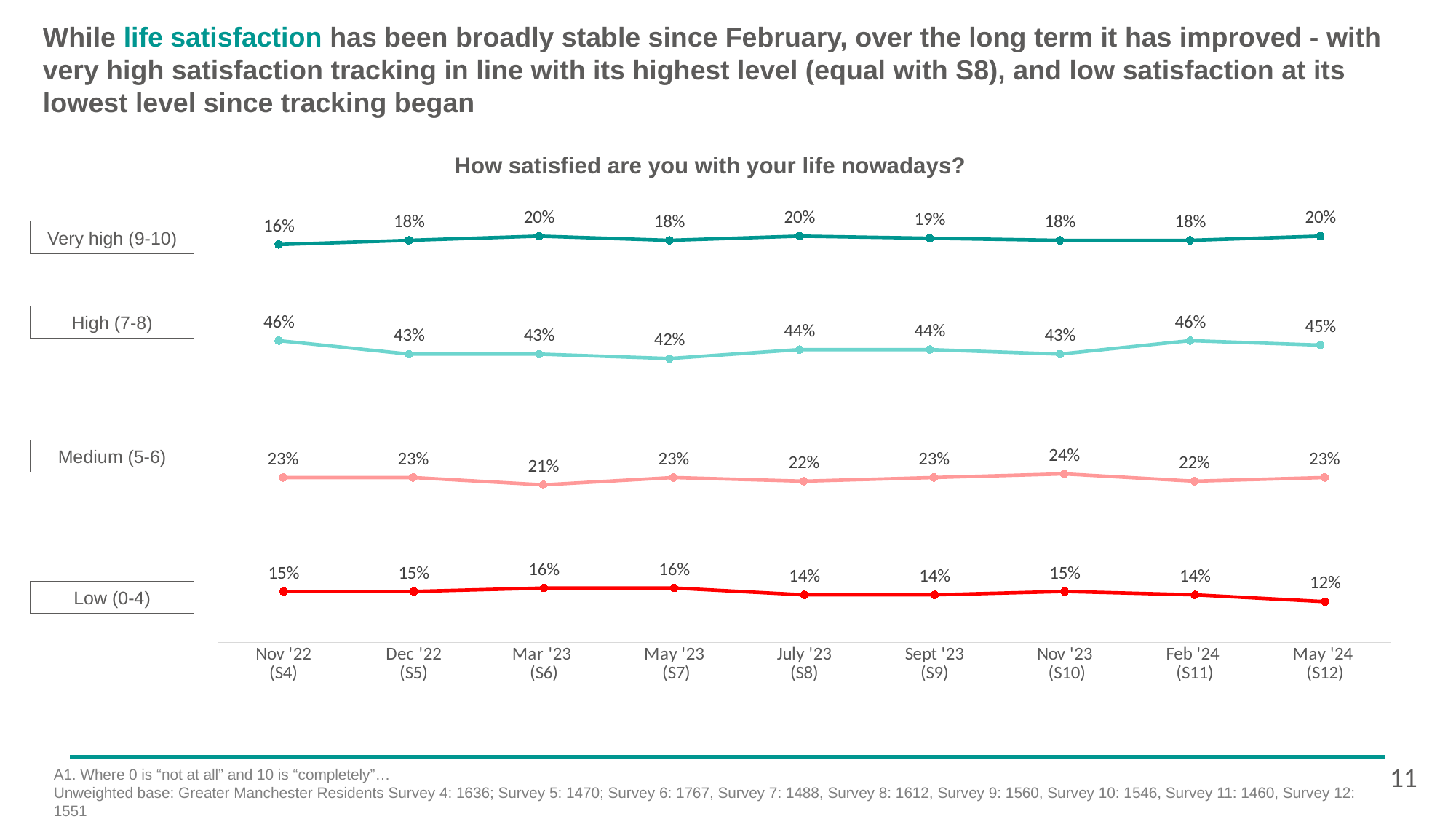
What is the difference between the High (7-8) value in Nov '22 (S4) and in Dec '22 (S5)? 3% What is the value for Low (0-4) in Nov '22 (S4)? 15% What is the value for Very high (9-10) in May '24 (S12)? 20% How many survey waves are shown on the x axis? 9 What type of chart is shown? Line chart Which is larger in Feb '24 (S11): the High (7-8) value or the Medium (5-6) value? High (7-8) What is the title of the chart? How satisfied are you with your life nowadays? In which survey wave is the Very high (9-10) value lowest? Nov '22 (S4) In which survey wave is the Low (0-4) value lowest? May '24 (S12) What is the value for Medium (5-6) in Nov '23 (S10)? 24% What is the value for High (7-8) in May '23 (S7)? 42% How many series are plotted on the chart? 4